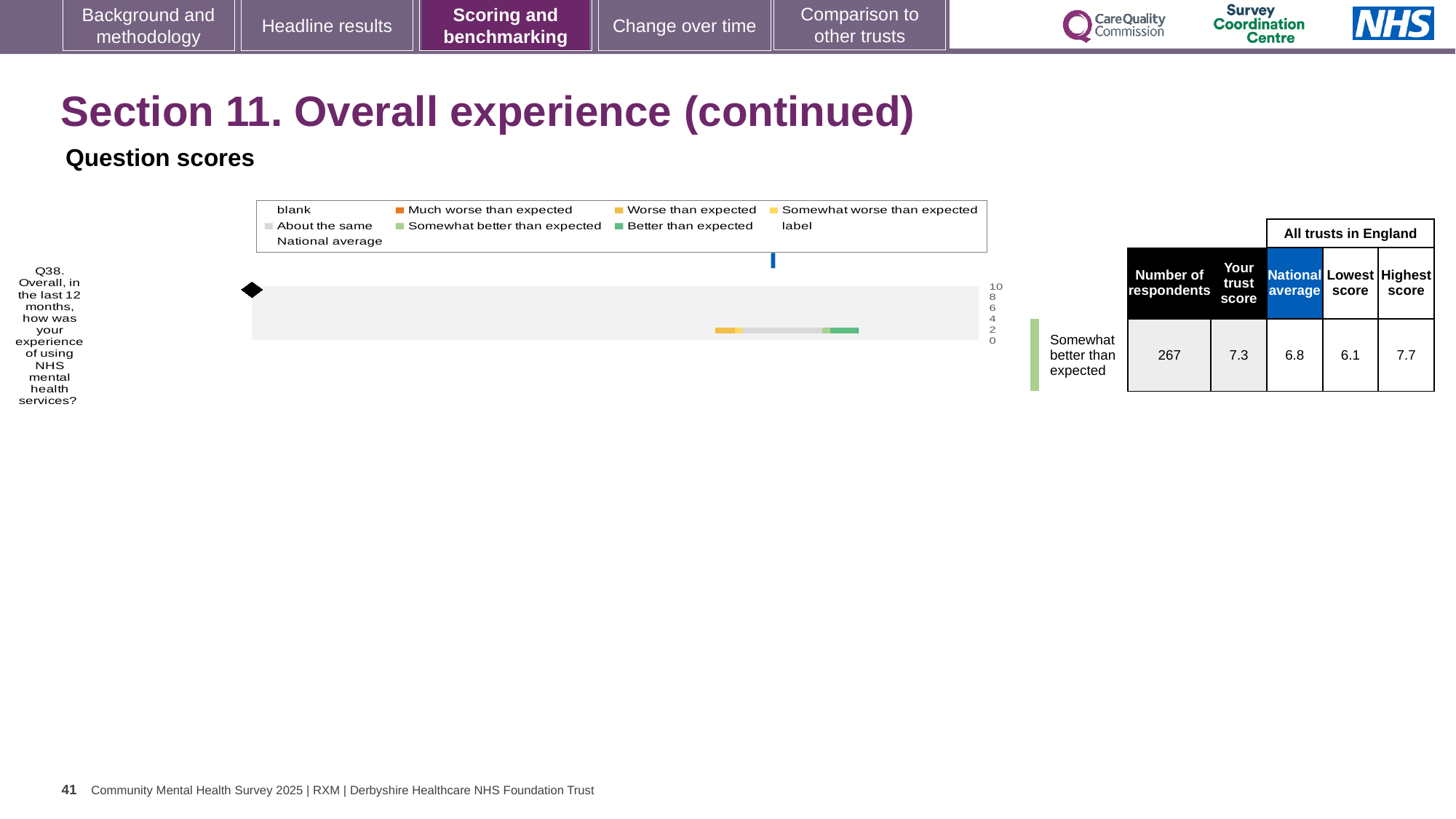
What kind of chart is shown on the slide? bar chart In the table beside the chart, what is the number of respondents for Q38? 267 How many questions (categories) are plotted in the chart? 1 In the table beside the chart, what is the trust's score for Q38? 7.3 What is the difference between the trust's score and the national average for Q38? 0.5 Is the trust's score for Q38 higher or lower than the national average? higher What is the difference between the highest and lowest scores among all trusts in England for Q38? 1.6 Which question is plotted in the chart? Q38. Overall, in the last 12 months, how was your experience of using NHS mental health services? In the table beside the chart, what is the national average for Q38? 6.8 In the table beside the chart, what is the highest score among all trusts in England for Q38? 7.7 In the table beside the chart, what is the lowest score among all trusts in England for Q38? 6.1 Which benchmark category is shown for Q38 next to the chart? Somewhat better than expected